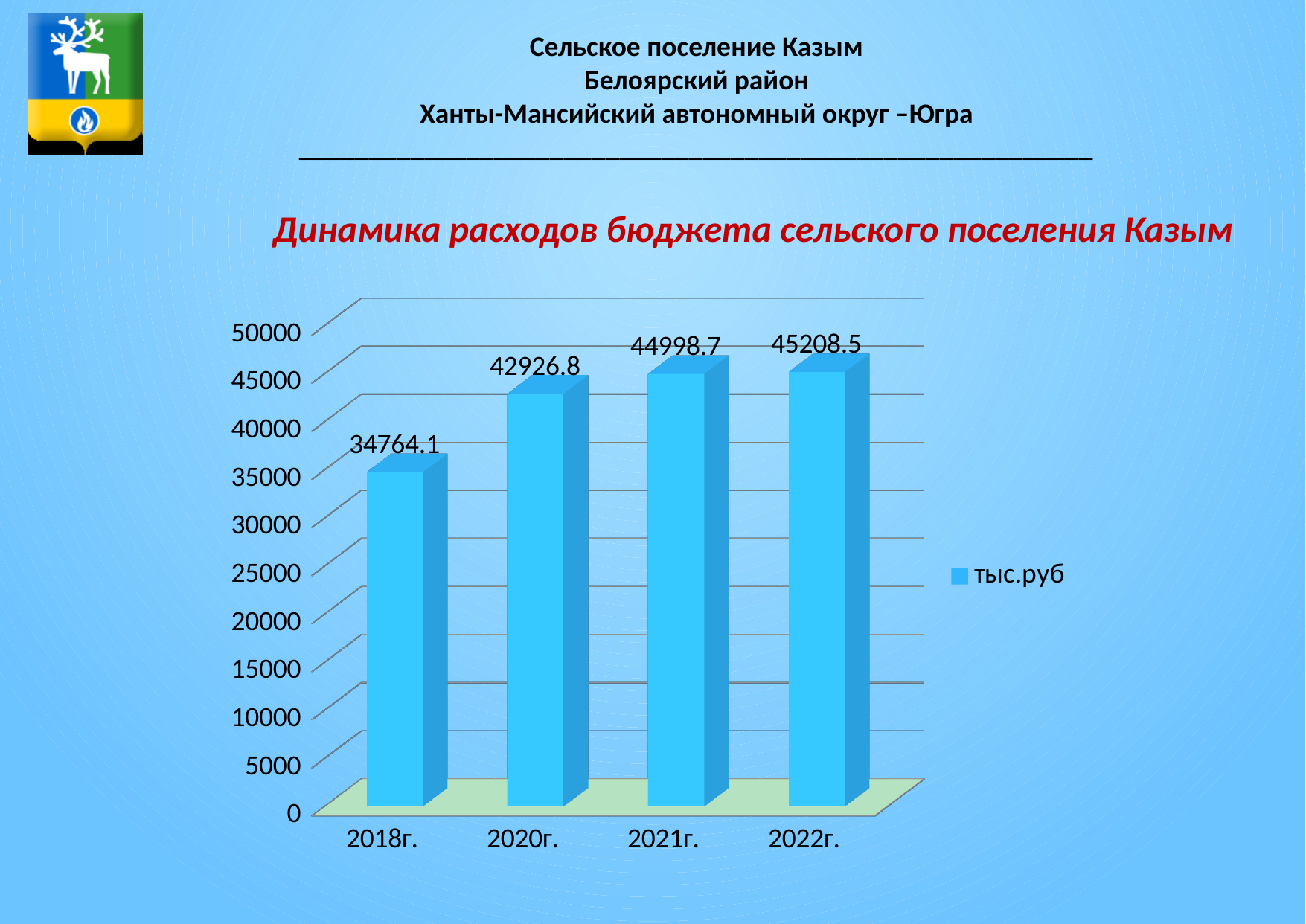
What is the difference between the values for 2021г. and 2020г.? 2071.9 How many years are shown on the x axis? 4 What is the value for 2021г.? 44998.7 What is the difference between the values for 2022г. and 2018г.? 10444.4 Which year has the lowest value? 2018г. Is the value for 2018г. greater or less than 40000? less Which year has the highest value? 2022г. Do the values rise or fall from 2018г. to 2022г.? rise What is the value for 2022г.? 45208.5 What kind of chart is shown on the slide? bar chart Which is larger, the value for 2020г. or the value for 2021г.? 2021г. What is the value for 2018г.? 34764.1